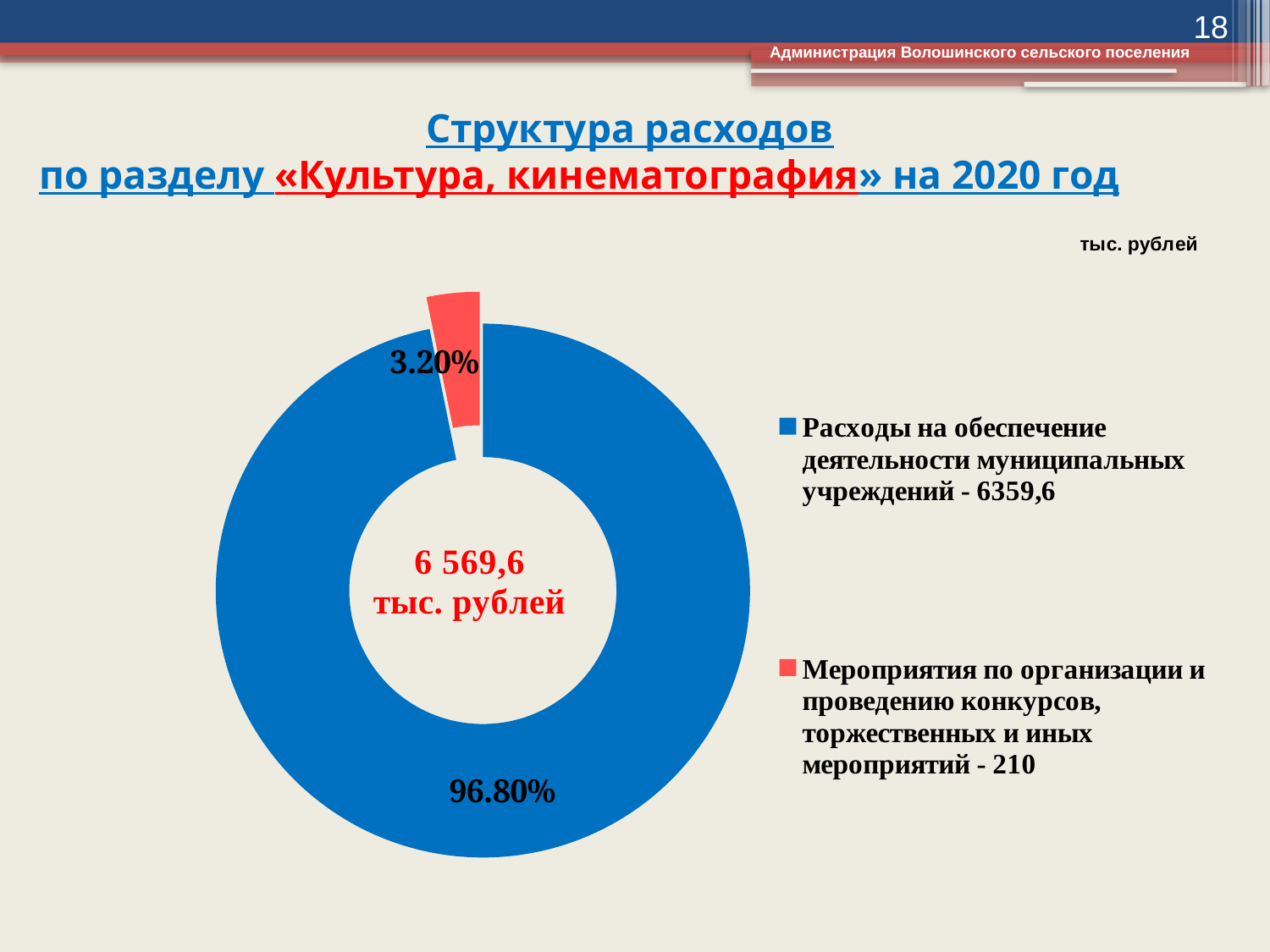
What total amount is printed in the centre of the doughnut chart? 6 569,6 тыс. рублей What colour is the slice for "Мероприятия по организации и проведению конкурсов, торжественных и иных мероприятий"? Red Which is larger: the share for "Расходы на обеспечение деятельности муниципальных учреждений" or the share for "Мероприятия по организации и проведению конкурсов, торжественных и иных мероприятий"? Расходы на обеспечение деятельности муниципальных учреждений What is the difference in percentage points between the 96.80% slice and the 3.20% slice? 93.60 percentage points What value (in тыс. рублей) does the legend give for "Расходы на обеспечение деятельности муниципальных учреждений"? 6359,6 Which category has the largest share of the chart? Расходы на обеспечение деятельности муниципальных учреждений What kind of chart is shown on the slide? Doughnut (pie) chart Which category has the smallest share of the chart? Мероприятия по организации и проведению конкурсов, торжественных и иных мероприятий What percentage share is shown for the slice "Мероприятия по организации и проведению конкурсов, торжественных и иных мероприятий"? 3.20% What value (in тыс. рублей) does the legend give for "Мероприятия по организации и проведению конкурсов, торжественных и иных мероприятий"? 210 How many categories does the chart show? 2 What percentage share is shown for the slice "Расходы на обеспечение деятельности муниципальных учреждений"? 96.80%